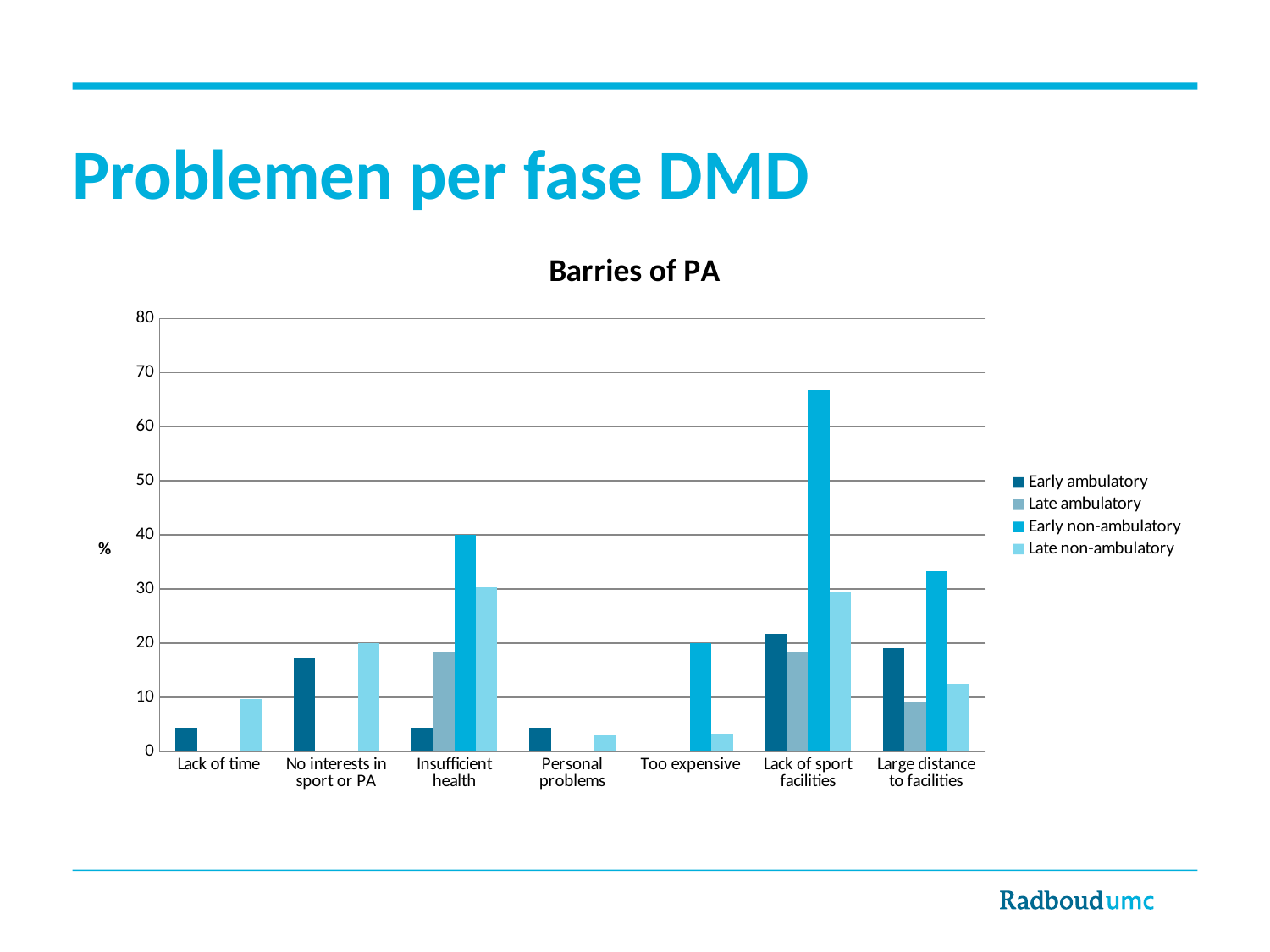
Which is larger for No interests in sport or PA: the Early ambulatory value or the Late non-ambulatory value? Late non-ambulatory How many series does the legend list? 4 How many categories are shown on the x axis? 7 What kind of chart is shown on the slide? bar chart What is the title of the chart? Barries of PA Which series has the highest value for Lack of sport facilities? Early non-ambulatory Which category has the highest bar in the chart? Lack of sport facilities Is the Early ambulatory value for Lack of time greater or less than 10? less What label is shown on the y axis? % Is the Early non-ambulatory value for Lack of sport facilities greater or less than 60? greater Which is larger for Large distance to facilities: the Early non-ambulatory value or the Late non-ambulatory value? Early non-ambulatory Is the Late non-ambulatory value for Insufficient health greater or less than 20? greater